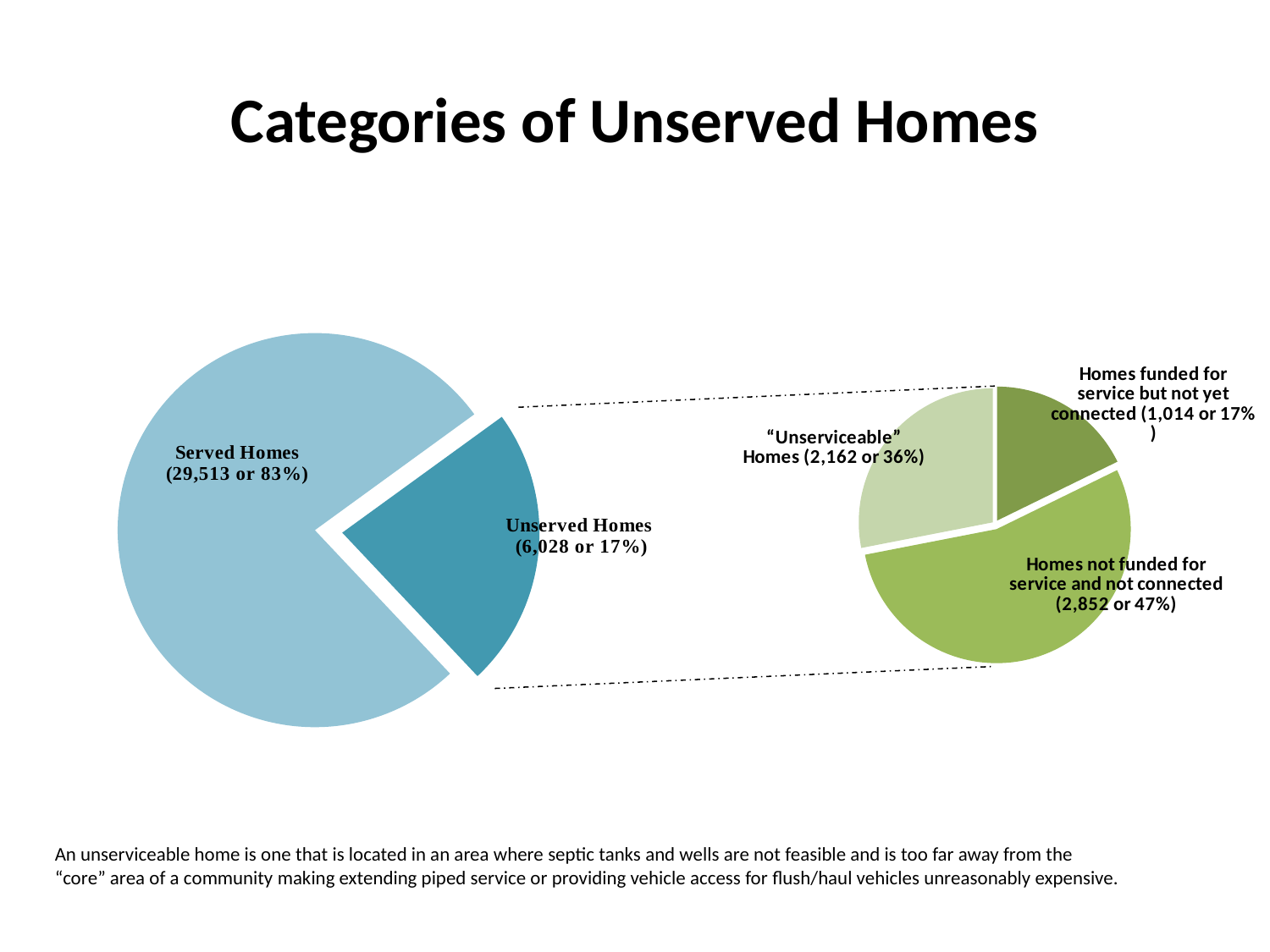
In the right pie chart, what is the difference between the number of homes not funded for service and not connected and the number of "Unserviceable" Homes? 690 In the right pie chart, what share of the pie is "Unserviceable" Homes? 36% In the left pie chart, how many Served Homes are there? 29,513 In the left pie chart, what share of the pie is Unserved Homes? 17% What is the title of the slide? Categories of Unserved Homes In the right pie chart, which is larger: "Unserviceable" Homes or Homes funded for service but not yet connected? "Unserviceable" Homes In the right pie chart, how many homes are not funded for service and not connected? 2,852 In the left pie chart, what share of the pie is Served Homes? 83% What kind of chart is the left chart? Pie chart How many slices does the right pie chart have? 3 In the right pie chart, which category has the largest slice? Homes not funded for service and not connected In the right pie chart, which category has the smallest slice? Homes funded for service but not yet connected